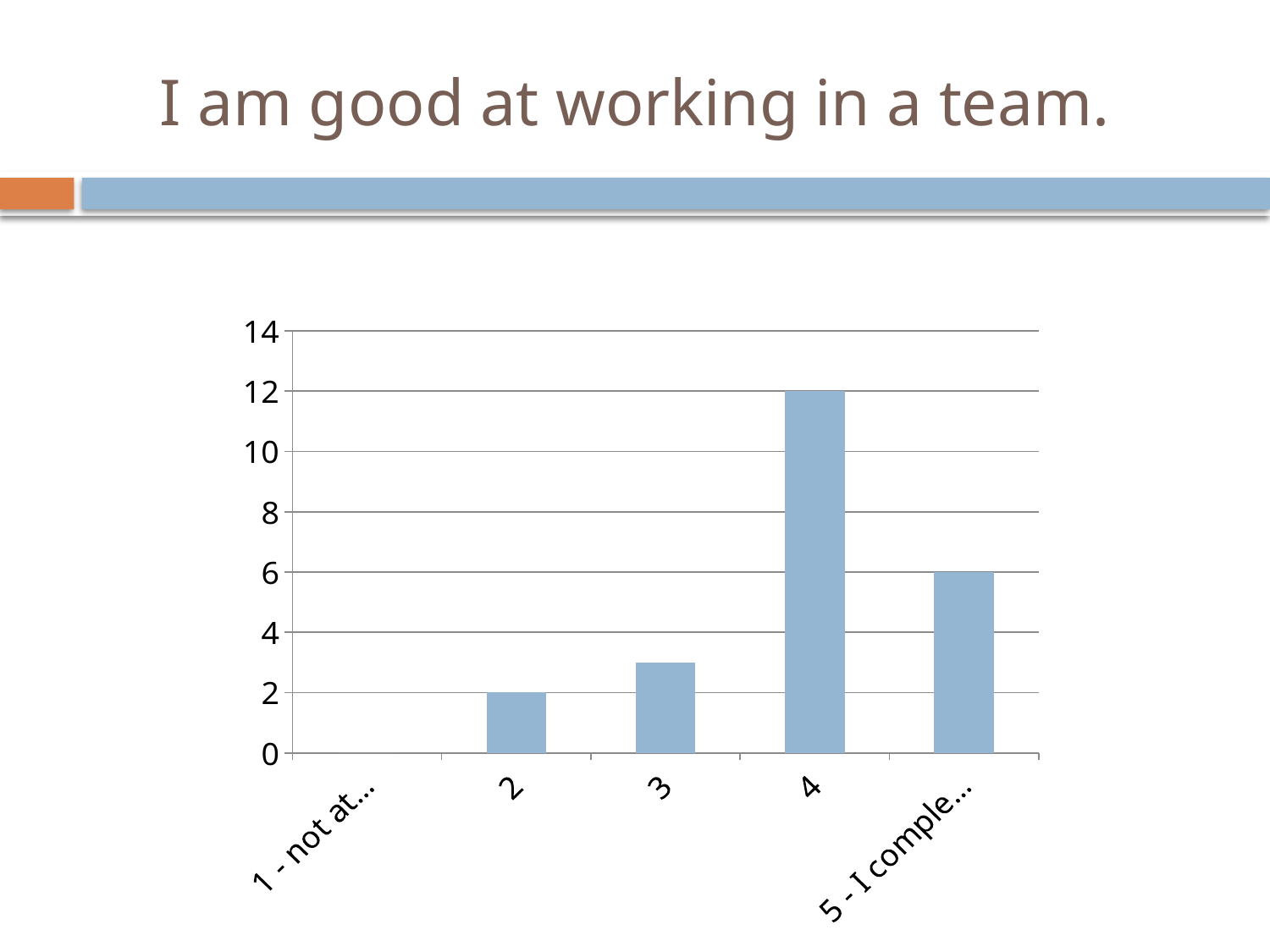
What kind of chart is shown on the slide? bar chart Which category has the lowest value? 1 - not at... Is the value for category 3 greater or less than 2? greater What is the value for the category labelled "5 - I comple..."? 6 Is the value for category 3 greater or less than 4? less Which is larger, the value for category 4 or the value for category 5? 4 What is the difference between the values for category 4 and category 2? 10 What is the difference between the values for category 4 and category 5? 6 What is the value for category 2? 2 Which category has the highest value? 4 How many categories are shown on the x axis? 5 What is the value for category 4? 12